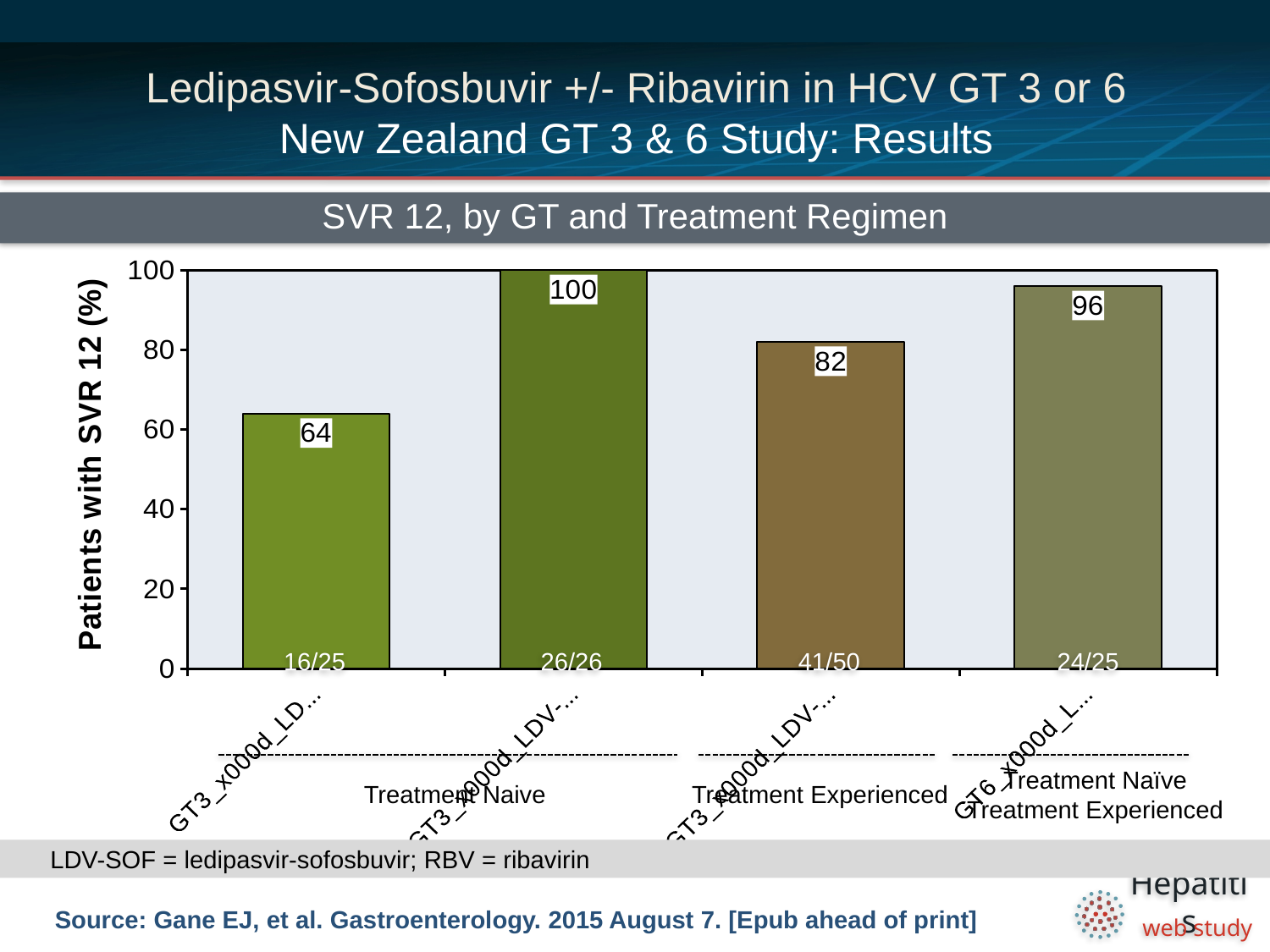
Which is larger, the value of the third bar or the fourth bar? the fourth bar (96) How many bars are plotted in the chart? 4 What is the title of the chart? SVR 12, by GT and Treatment Regimen Which bar has the lowest value in the chart? the first bar (64) Which bar has the highest value in the chart? the second bar (100) What is the value of the fourth (rightmost) bar in the chart? 96 What is the value of the first (leftmost) bar in the chart? 64 What is the difference between the value of the second bar (100) and the first bar (64)? 36 What fraction of patients is printed at the base of the bar with value 82? 41/50 What is the value of the third bar from the left in the chart? 82 What type of chart is shown on the slide? bar chart What is the value of the second bar from the left in the chart? 100